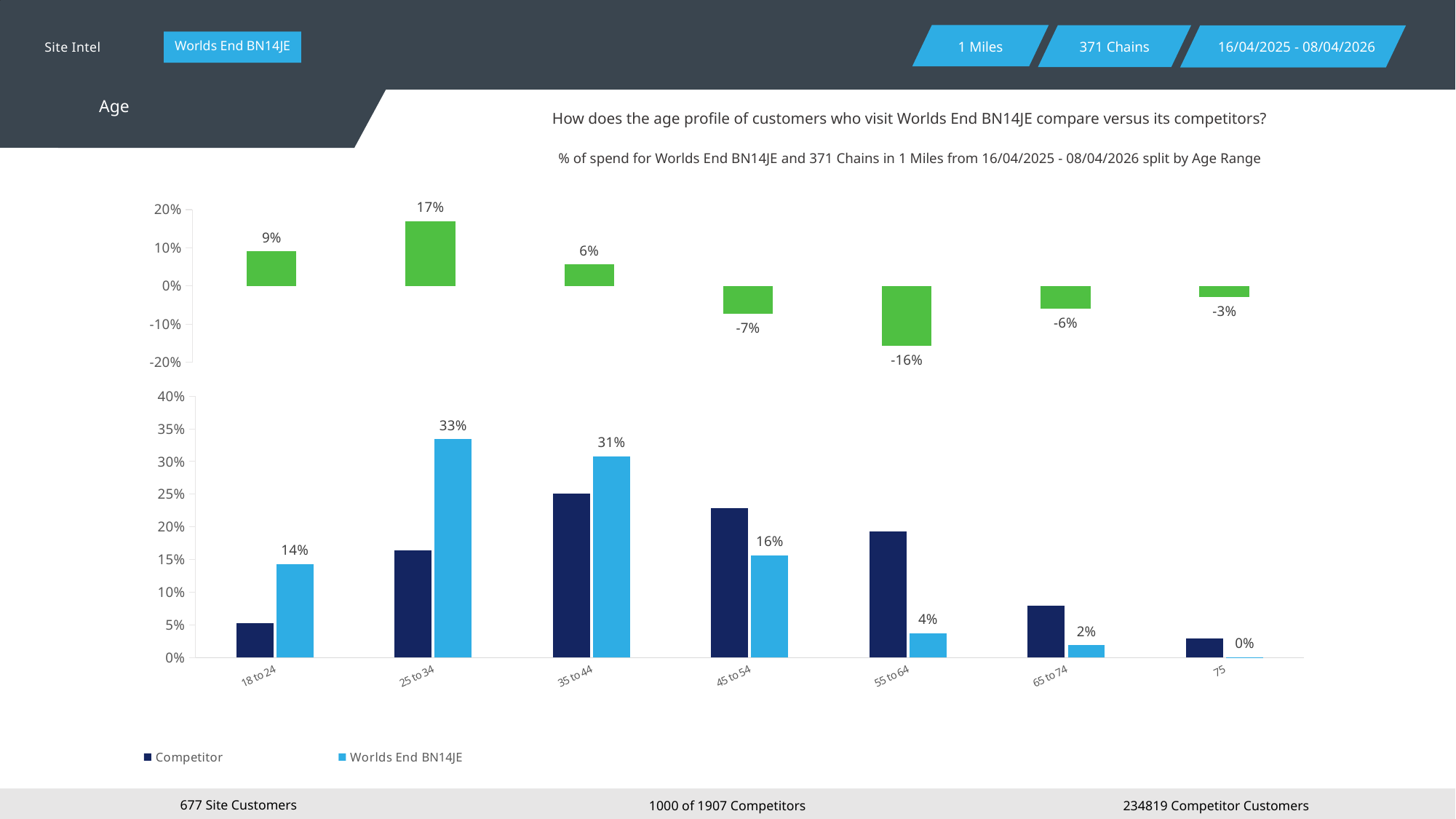
In the top chart, which age range has the lowest value? 55 to 64 In the bottom chart, is the Competitor value for 35 to 44 greater or less than 20%? greater In the top chart, what is the value shown for the 55 to 64 age range? -16% In the top chart, what is the value shown for the 18 to 24 age range? 9% In the top chart, which age range has the highest value? 25 to 34 In the bottom chart, which is larger for the 45 to 54 age range, the Competitor bar or the Worlds End BN14JE bar? Competitor In the bottom chart, what is the value for Worlds End BN14JE in the 55 to 64 age range? 4% In the bottom chart, what is the value for Worlds End BN14JE in the 25 to 34 age range? 33% In the bottom chart, what is the difference between the Worlds End BN14JE values for 25 to 34 and 45 to 54? 17% In the bottom chart, which age range has the lowest Worlds End BN14JE value? 75 How many series does the legend of the bottom chart list? 2 How many age range categories are shown on the x axis of the bottom chart? 7